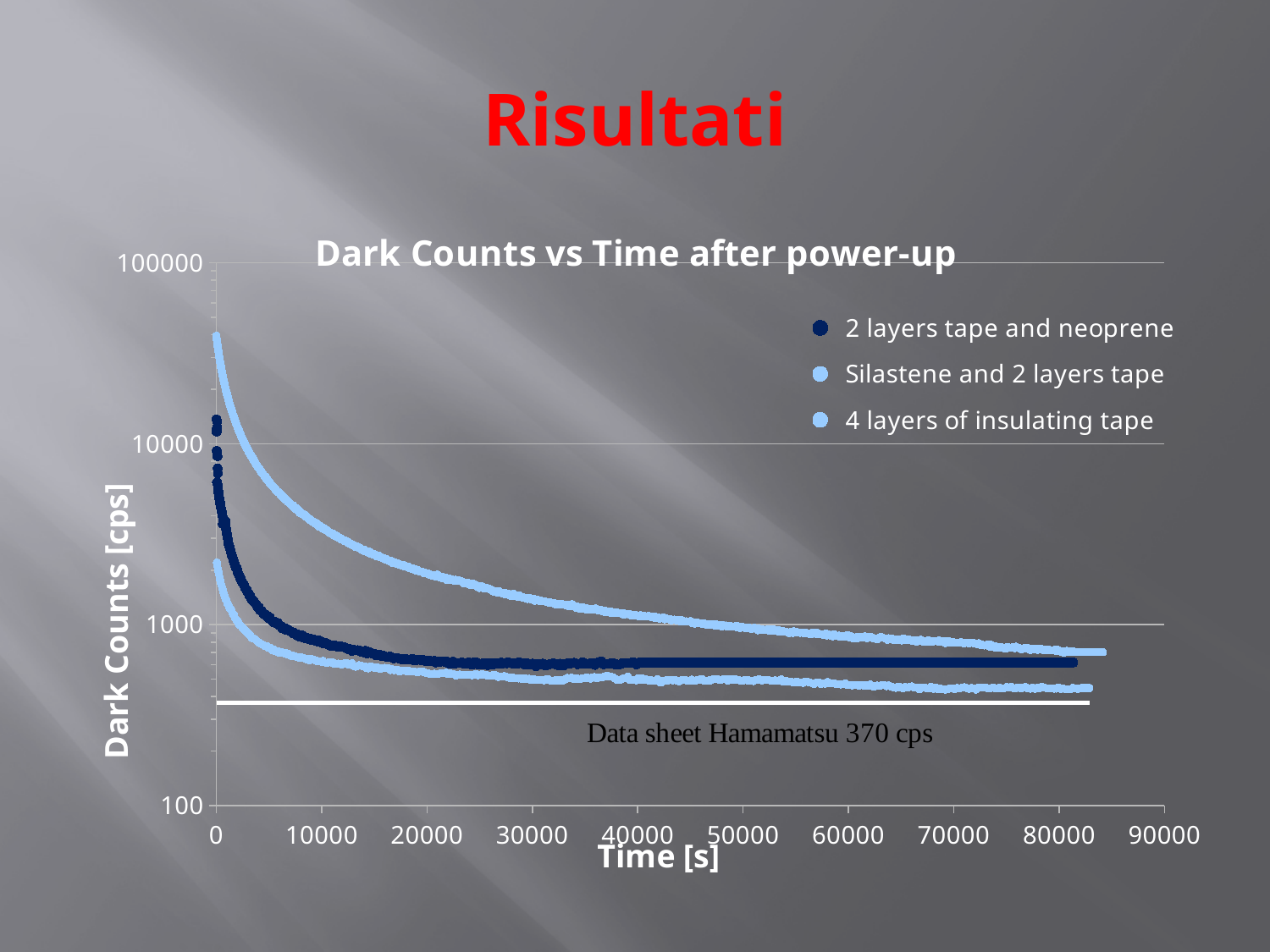
Is the starting value of the '2 layers tape and neoprene' series at time 0 greater or less than 10000? greater Do the dark counts rise or fall as time increases along the x axis? fall How many series does the chart legend list? 3 What is the title of the chart? Dark Counts vs Time after power-up Is the value of the '2 layers tape and neoprene' series at 80000 s greater or less than 1000? less What dark count value does the Hamamatsu data sheet reference line on the chart correspond to? 370 cps What is the label of the y axis? Dark Counts [cps] Do any of the three series drop below the Hamamatsu data sheet line of 370 cps? No What is the highest value shown on the y axis? 100000 What is the largest tick value shown on the x axis? 90000 Is the value of the '2 layers tape and neoprene' series at 40000 s greater or less than 370 cps? greater What kind of chart is shown on the slide? scatter chart